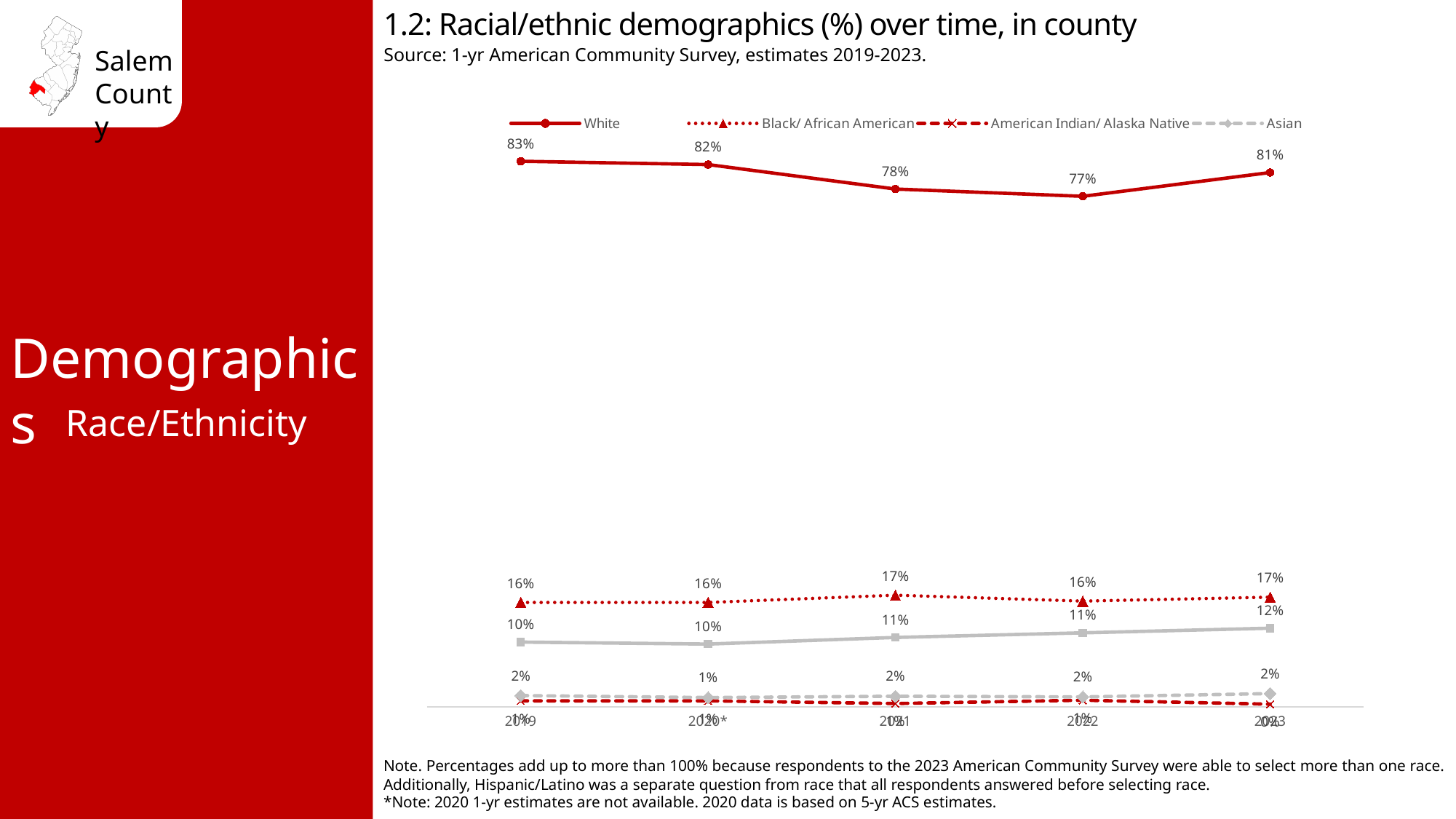
Which was larger in 2023, the White percentage or the Black/ African American percentage? White How many years are shown on the x axis? 5 What was the White percentage in 2022? 77% What was the Black/ African American percentage in 2021? 17% How many series does the legend list? 4 What is the difference between the White percentage in 2019 and in 2022? 6% In which year was the White percentage lowest? 2022 What was the White percentage in 2019? 83% Did the White percentage rise or fall from 2019 to 2022? Fall What was the Asian percentage in 2020? 1% In which year was the White percentage highest? 2019 What kind of chart is shown? Line chart